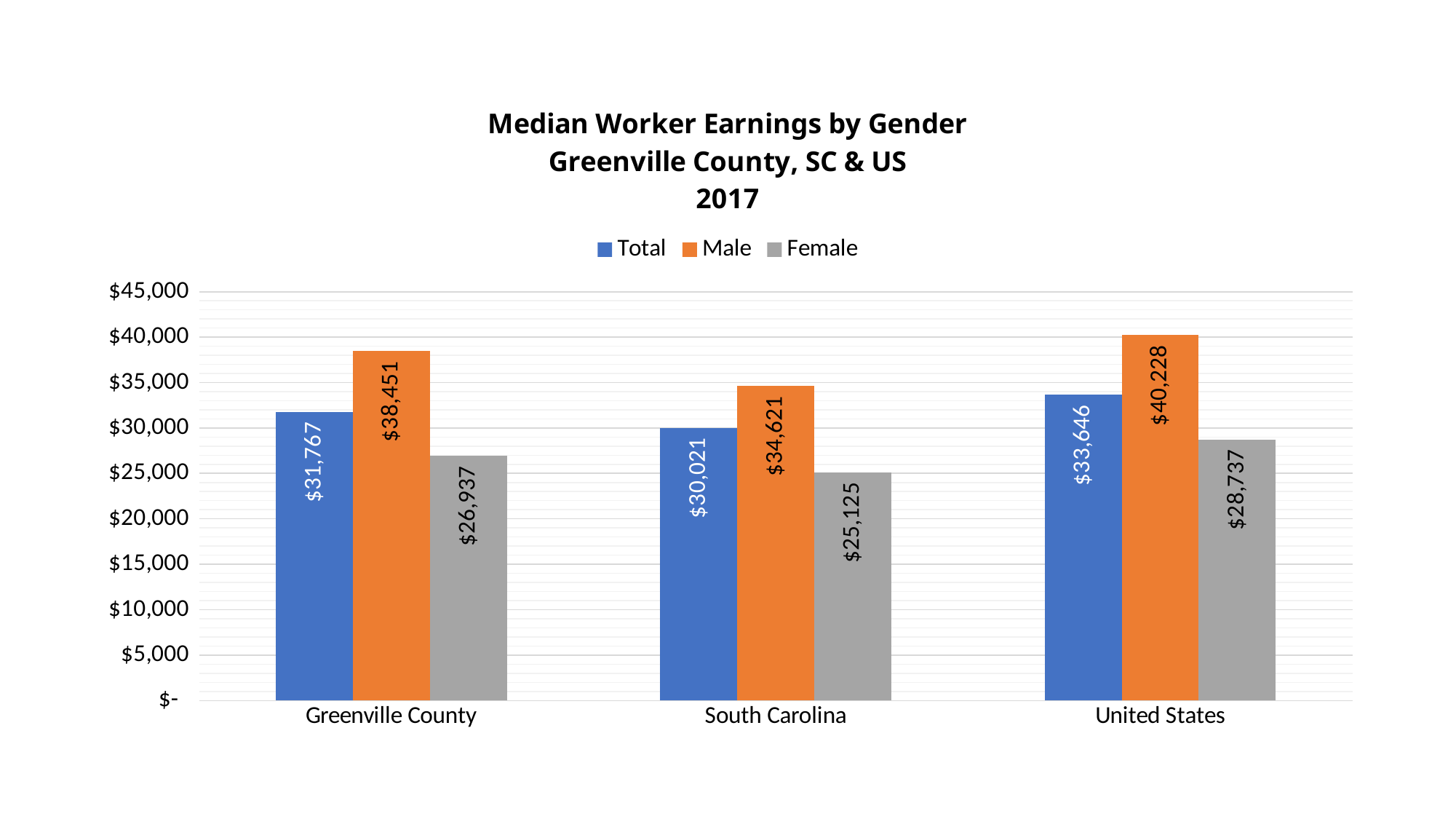
What kind of chart is shown on the slide? Bar chart What is the median earnings for Female workers in South Carolina? $25,125 Is the Male median earnings for the United States greater or less than $40,000? greater Which is larger: Female median earnings in Greenville County or Female median earnings in the United States? United States How many regions are shown on the x axis? 3 How many series does the legend list? 3 Which region has the lowest Female median earnings? South Carolina What is the difference between the Total median earnings of the United States and South Carolina? $3,625 What is the median earnings for Male workers in Greenville County? $38,451 Which region has the highest Male median earnings? United States What is the difference between Male and Female median earnings in Greenville County? $11,514 What is the Total median earnings for the United States? $33,646